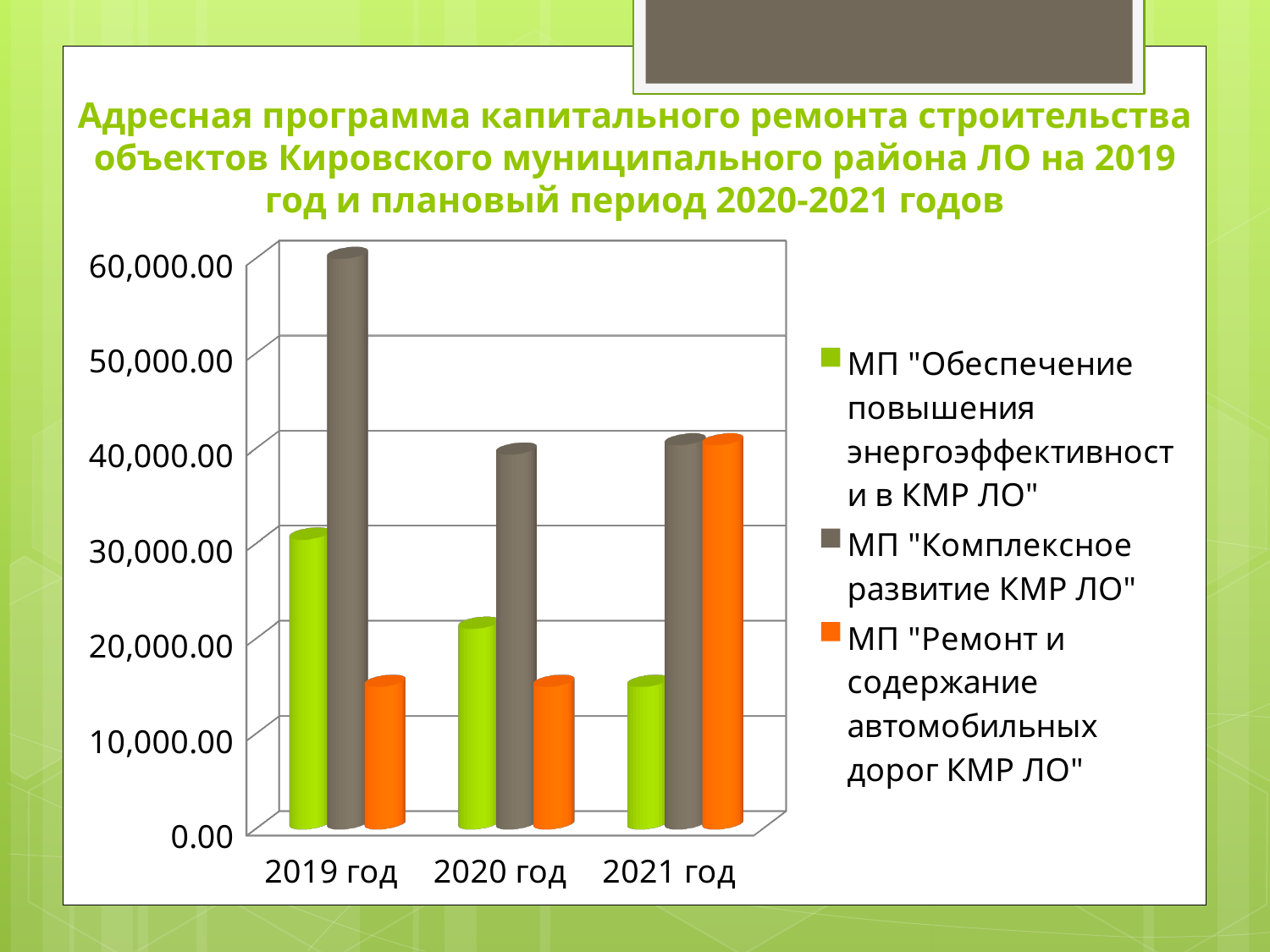
In which year is the value for МП "Обеспечение повышения энергоэффективности в КМР ЛО" lowest? 2021 год In which year is the value for МП "Комплексное развитие КМР ЛО" highest? 2019 год What colour represents МП "Ремонт и содержание автомобильных дорог КМР ЛО" in the chart? orange In 2019 год, which is larger: МП "Обеспечение повышения энергоэффективности в КМР ЛО" or МП "Ремонт и содержание автомобильных дорог КМР ЛО"? МП "Обеспечение повышения энергоэффективности в КМР ЛО" How many year categories are shown on the x axis? 3 Do the values for МП "Обеспечение повышения энергоэффективности в КМР ЛО" rise or fall from 2019 год to 2021 год? fall Is the value for МП "Комплексное развитие КМР ЛО" in 2020 год greater or less than 30,000.00? greater How many series does the legend list? 3 Is the value for МП "Комплексное развитие КМР ЛО" in 2019 год greater or less than 50,000.00? greater What kind of chart is shown on the slide? bar chart Is the value for МП "Ремонт и содержание автомобильных дорог КМР ЛО" in 2019 год greater or less than 20,000.00? less